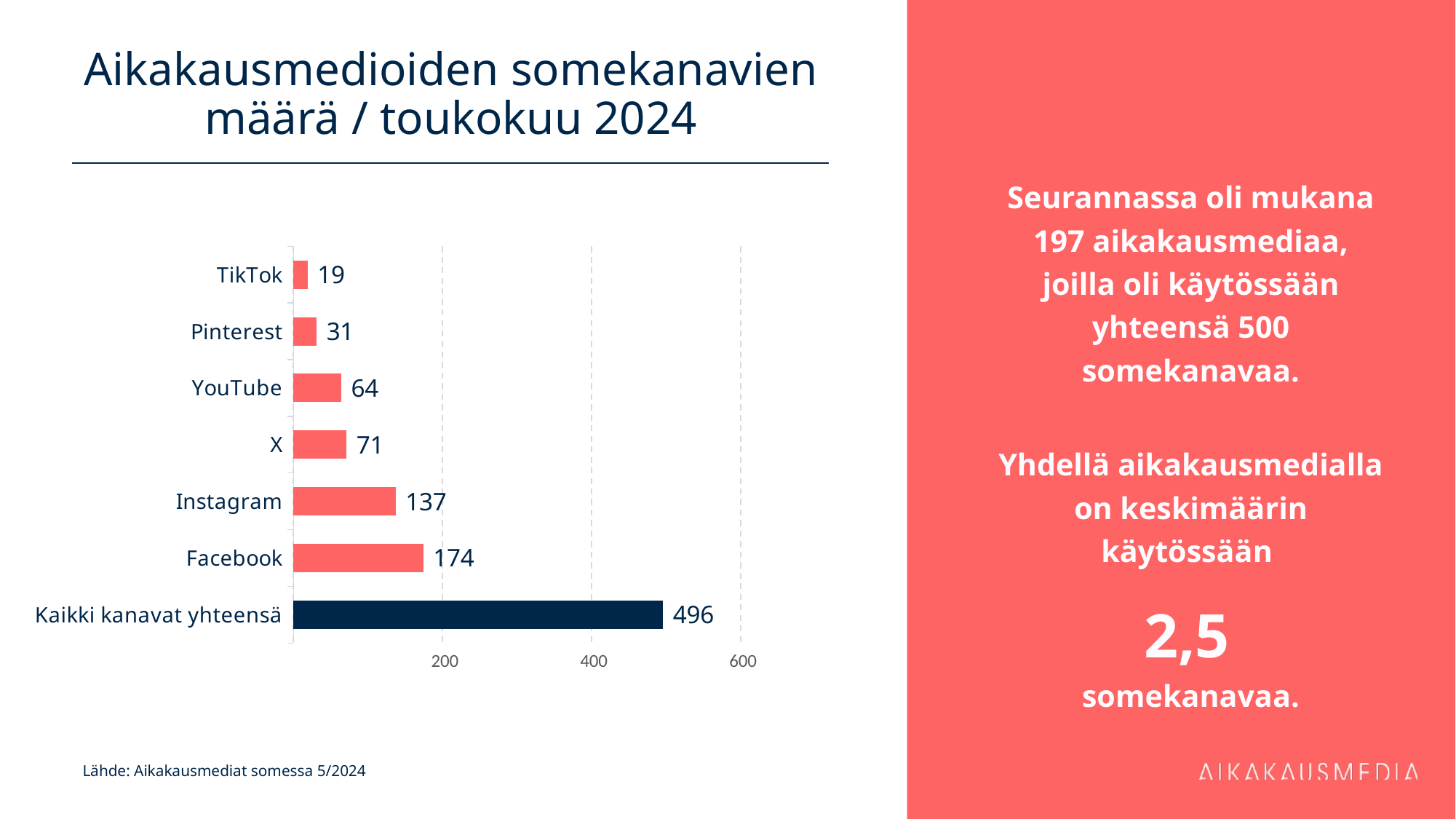
What is the value for Instagram? 137 What kind of chart is shown on the slide? Bar chart What is the difference between the values for Facebook and Instagram? 37 Which is larger, the value for Pinterest or the value for YouTube? YouTube What is the value for Kaikki kanavat yhteensä? 496 What is the difference between the values for X and YouTube? 7 What is the title of the chart on the slide? Aikakausmedioiden somekanavien määrä / toukokuu 2024 Which category has the lowest value? TikTok How many categories are shown in the chart? 7 Which individual channel (excluding the total bar) has the highest value? Facebook What is the value for Facebook? 174 What is the value for TikTok? 19